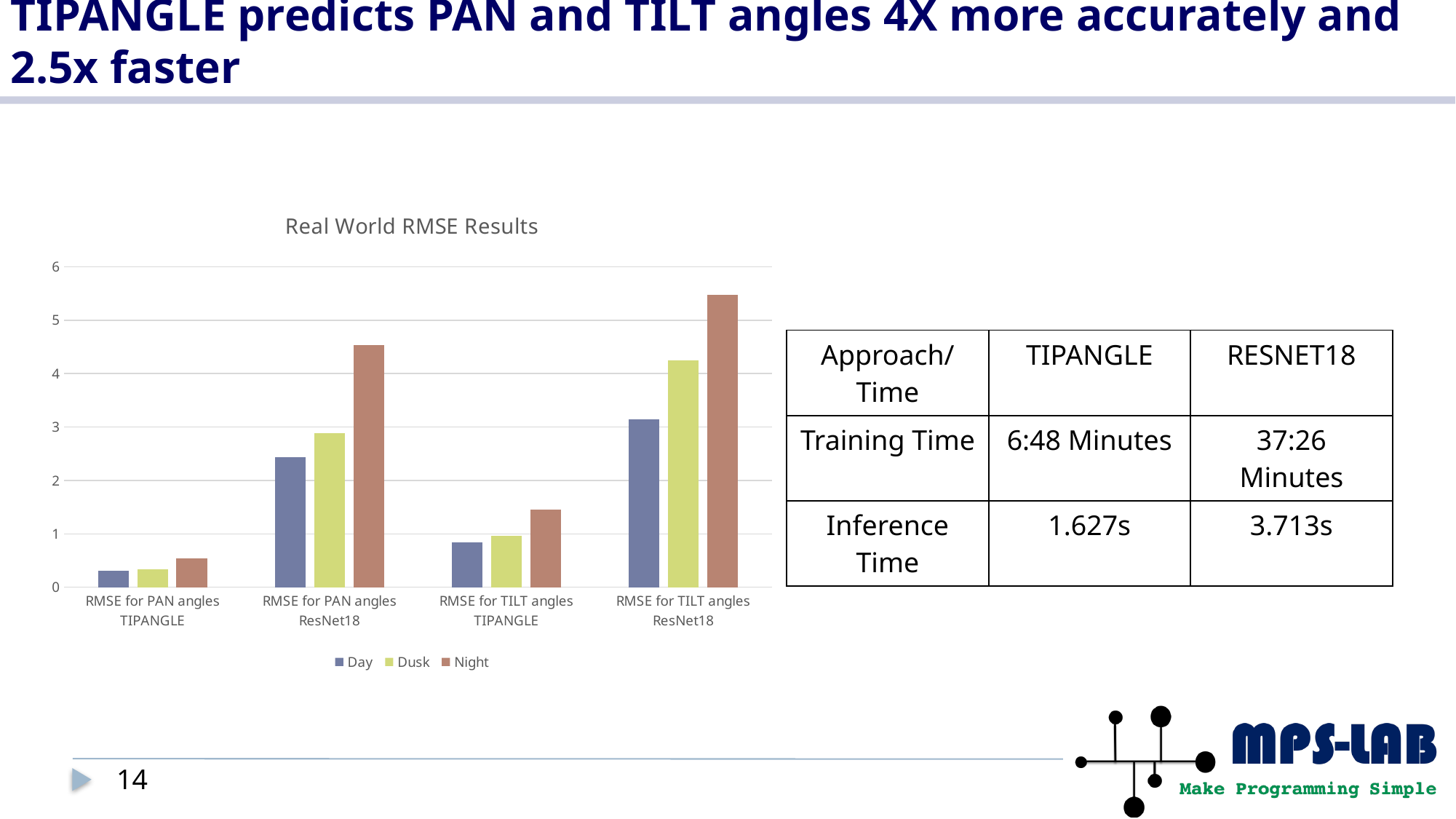
What kind of chart is shown on the slide? bar chart Which is larger: the Night value for RMSE for PAN angles ResNet18 or the Night value for RMSE for TILT angles ResNet18? RMSE for TILT angles ResNet18 Is the Day value for RMSE for TILT angles ResNet18 greater or less than 4? less Which is larger: the Dusk value for RMSE for PAN angles TIPANGLE or the Dusk value for RMSE for TILT angles TIPANGLE? RMSE for TILT angles TIPANGLE What are the entries in the chart's legend? Day, Dusk, Night Is the Night value for RMSE for TILT angles TIPANGLE greater or less than 2? less How many categories are shown on the x axis of the chart? 4 How many series does the legend of the chart list? 3 What is the title of the chart? Real World RMSE Results Which category has the lowest Day value? RMSE for PAN angles TIPANGLE Is the Night value for RMSE for PAN angles ResNet18 greater or less than 4? greater Which category has the highest Night value? RMSE for TILT angles ResNet18